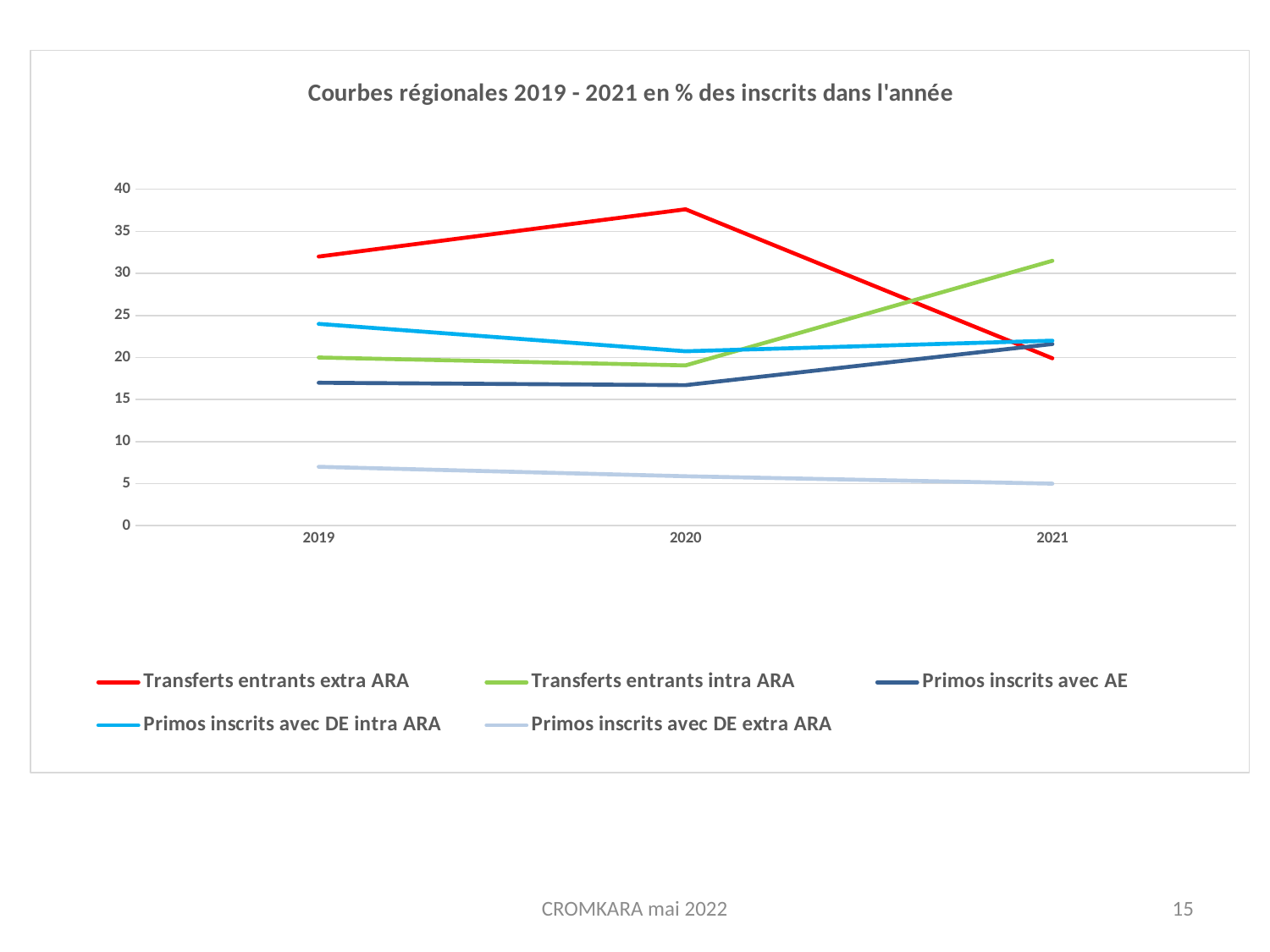
Is the value for Transferts entrants extra ARA in 2020 greater or less than 35? greater In 2019, which is larger: Transferts entrants extra ARA or Primos inscrits avec DE intra ARA? Transferts entrants extra ARA How many series does the legend list? 5 Is the value for Primos inscrits avec AE in 2019 greater or less than 20? less Which series has the lowest value in 2021? Primos inscrits avec DE extra ARA What is the title of the chart? Courbes régionales 2019 - 2021 en % des inscrits dans l'année Which series has the highest value in 2021? Transferts entrants intra ARA Does the Primos inscrits avec DE extra ARA series rise or fall from 2019 to 2021? fall How many years are plotted along the x axis? 3 Is the value for Primos inscrits avec DE extra ARA in 2019 greater or less than 10? less Which series has the highest value in 2020? Transferts entrants extra ARA What kind of chart is shown on the slide? line chart